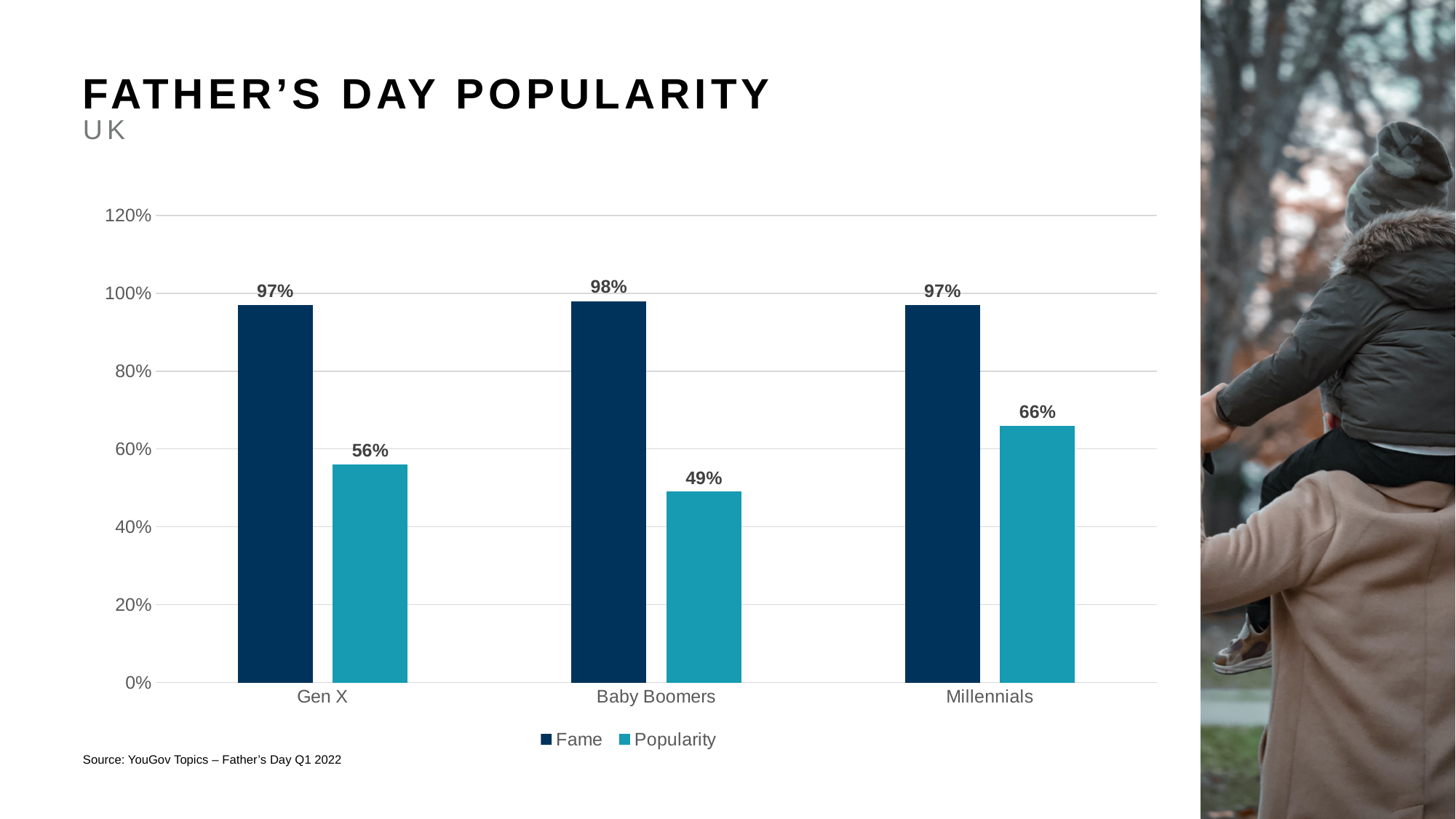
What is the Popularity value for Baby Boomers? 49% Which generation has the highest Popularity value? Millennials How many generation categories are shown on the x axis? 3 What is the difference between the Fame and Popularity values for Gen X? 41% How many series does the legend list? 2 Which generation has the lowest Popularity value? Baby Boomers What kind of chart is shown on the slide? Bar chart What is the Fame value for Gen X? 97% What is the Popularity value for Millennials? 66% What is the difference between the Popularity values for Millennials and Baby Boomers? 17% Which is larger, the Popularity value for Gen X or for Millennials? Millennials What is the Fame value for Baby Boomers? 98%